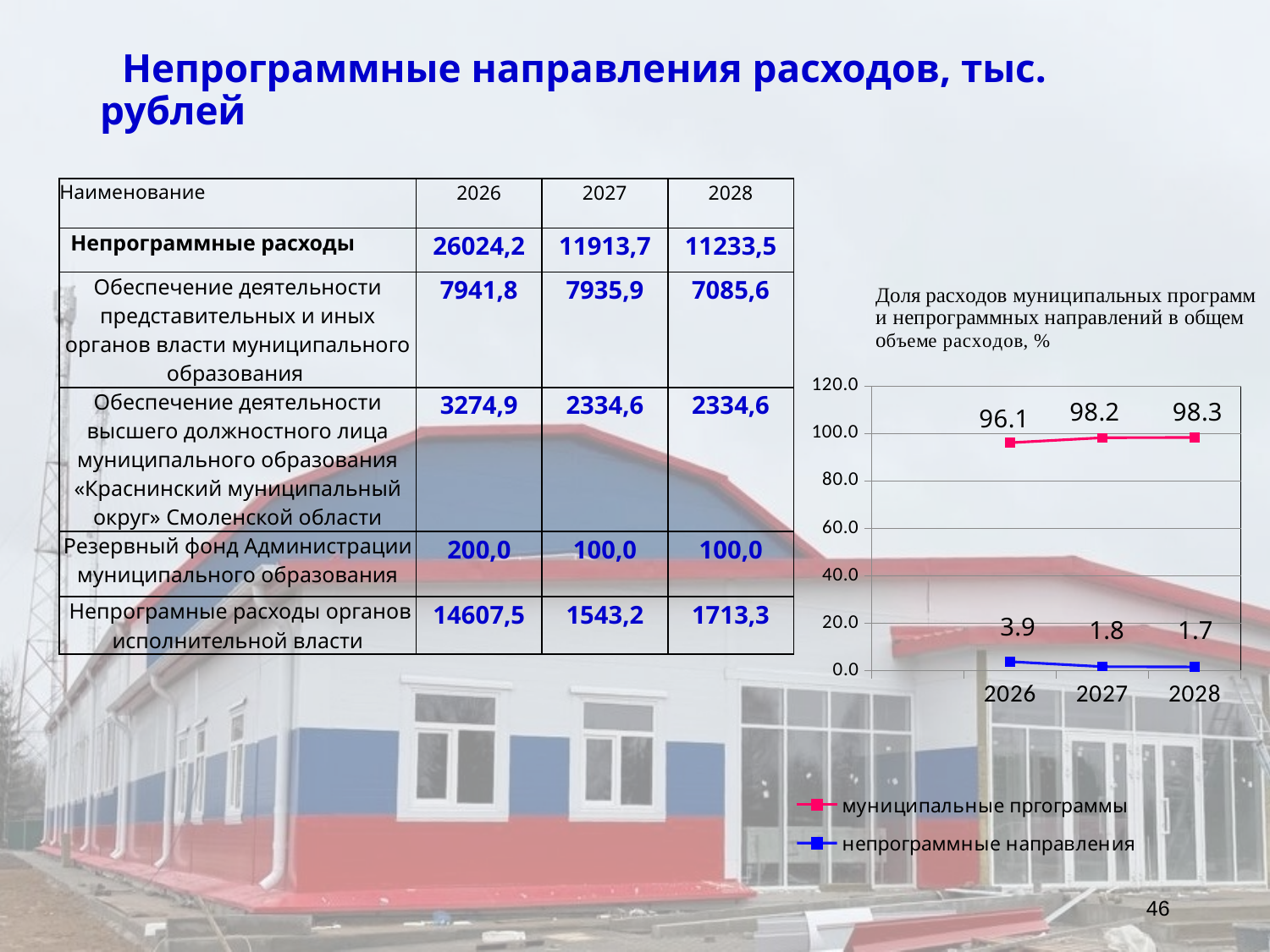
What is the difference between the муниципальные программы values for 2028 and 2026? 2.2 Which is larger in 2027: муниципальные программы or непрограммные направления? муниципальные программы What type of chart is shown on the slide? line chart What is the value for муниципальные программы in 2026? 96.1 How many series does the legend list? 2 How many years are shown on the x axis of the chart? 3 What is the value for муниципальные программы in 2028? 98.3 Do the values for непрограммные направления rise or fall from 2026 to 2028? fall In which year is the value for непрограммные направления the highest? 2026 What is the value for непрограммные направления in 2026? 3.9 What is the value for непрограммные направления in 2027? 1.8 In which year is the value for муниципальные программы the lowest? 2026